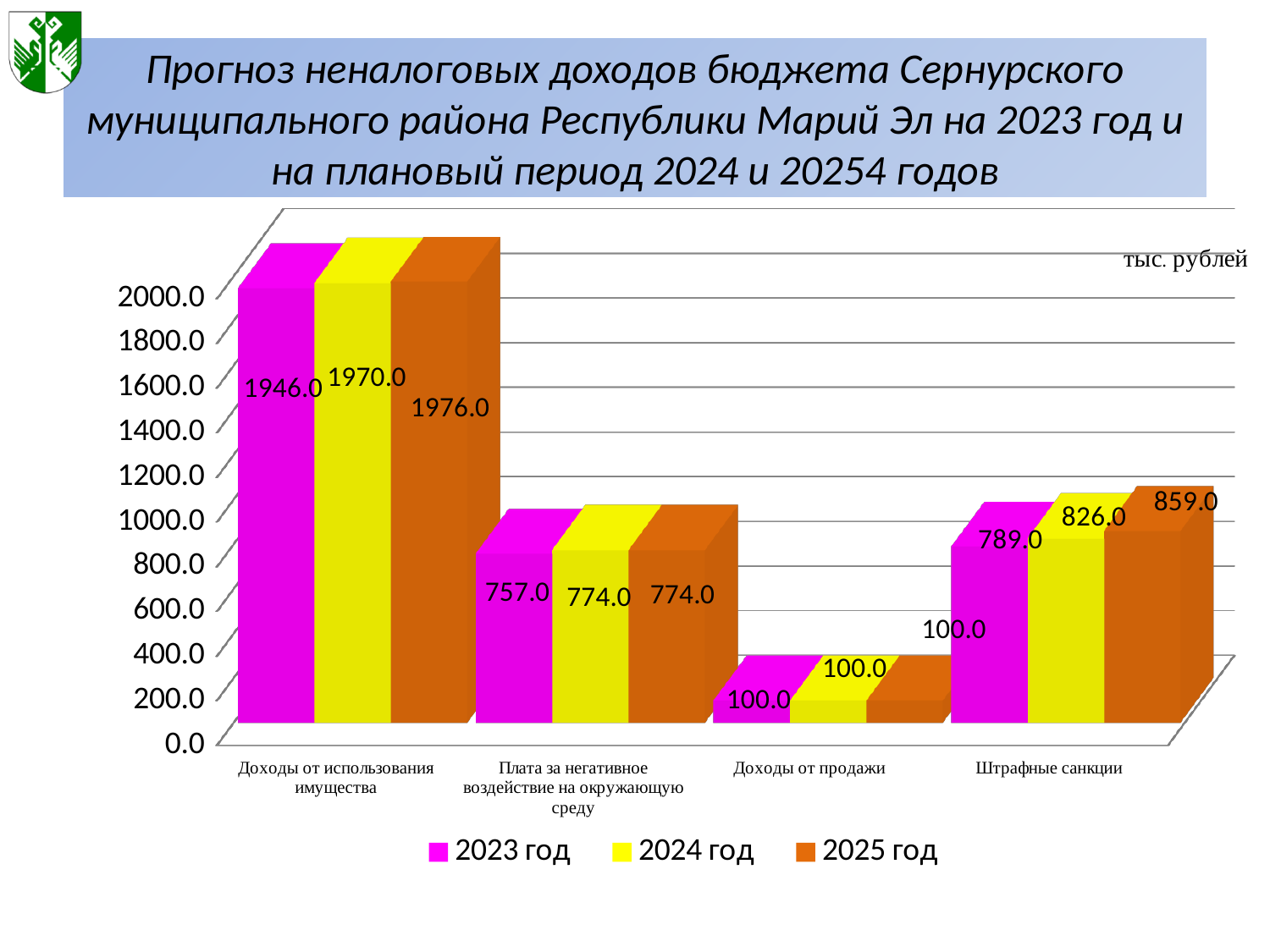
What is the value for 2024 год for Плата за негативное воздействие на окружающую среду? 774.0 What is the value for 2023 год for Доходы от использования имущества? 1946.0 Which category has the highest value for 2025 год? Доходы от использования имущества What unit is indicated in the top right corner of the chart? тыс. рублей How many categories are shown on the x axis? 4 How many series does the legend list? 3 What is the value for 2023 год for Доходы от продажи? 100.0 Which is larger for Плата за негативное воздействие на окружающую среду: the 2023 год value or the 2024 год value? 2024 год What is the difference between the 2025 год and 2023 год values for Штрафные санкции? 70.0 What kind of chart is shown on the slide? Bar chart Which category has the lowest value for 2024 год? Доходы от продажи What is the value for 2025 год for Штрафные санкции? 859.0